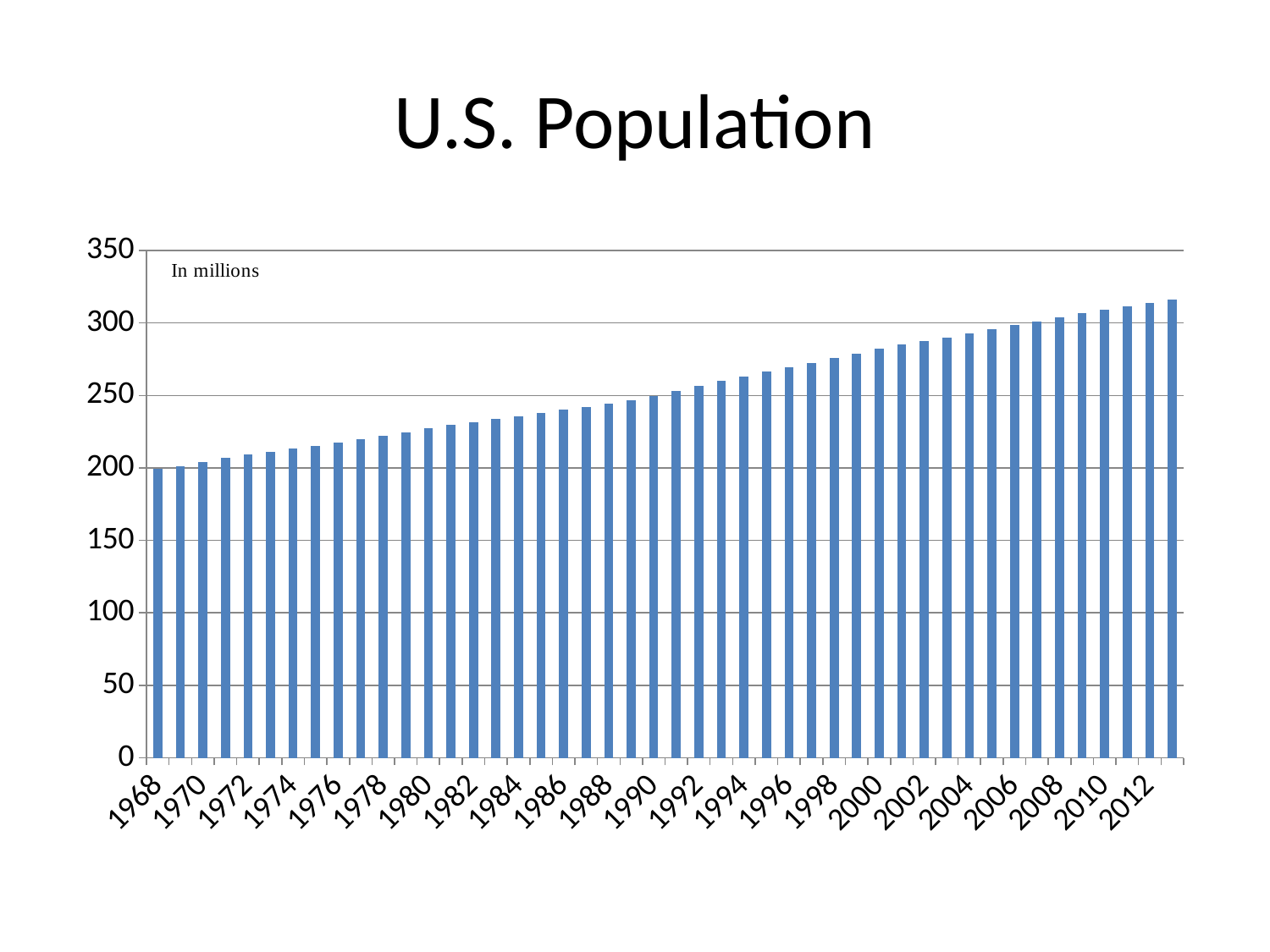
What is the title of the chart? U.S. Population Is the value for 2012 greater or less than 300? greater Is the value for 1968 greater or less than 250? less Is the value for 2000 greater or less than 250? greater Which is larger, the value for 1980 or the value for 2000? 2000 Do the population values rise or fall from 1968 to 2012? rise What kind of chart is shown on the slide? bar chart How many year labels are shown on the x axis? 23 Which year has the lowest population bar? 1968 In what units are the population values given, according to the note inside the chart? In millions